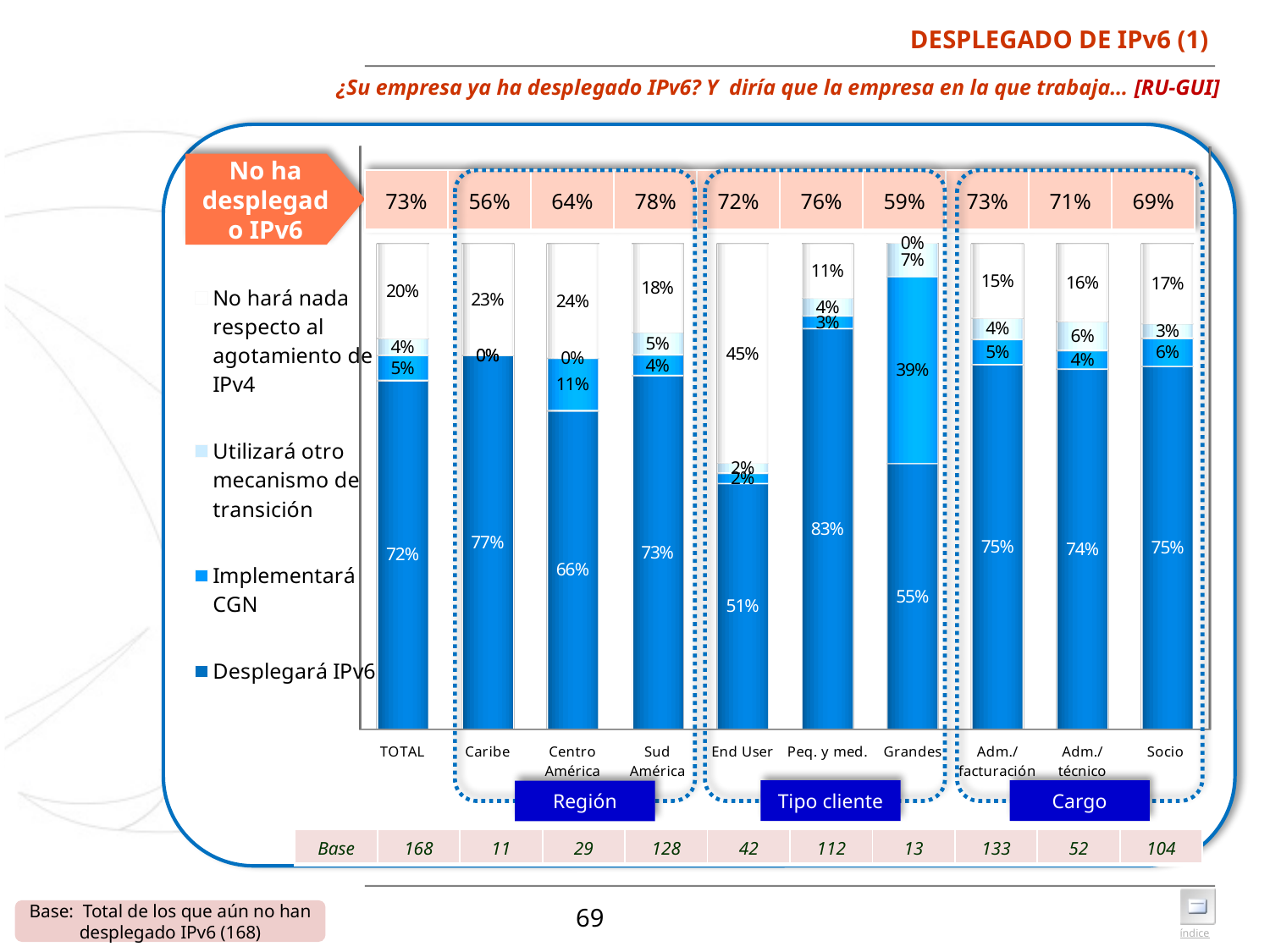
Which is larger, the 'No hará nada respecto al agotamiento de IPv4' value for TOTAL or for Sud América? TOTAL What percentage of End User respondents say they will deploy IPv6 (Desplegará IPv6)? 51% What is the 'No ha desplegado IPv6' percentage shown above the Sud América bar? 78% Which category has the highest 'Desplegará IPv6' value? Peq. y med. What is the 'No hará nada respecto al agotamiento de IPv4' value for Centro América? 24% Which group label covers the End User, Peq. y med. and Grandes categories? Tipo cliente What is the difference between the 'Desplegará IPv6' values for Caribe and Centro América? 11% What kind of chart is shown on the slide? Stacked bar chart How many series does the legend list? 4 Which category has the lowest 'Desplegará IPv6' value? End User How many categories are shown along the x axis of the chart? 10 What is the 'Implementará CGN' value for the Grandes category? 39%